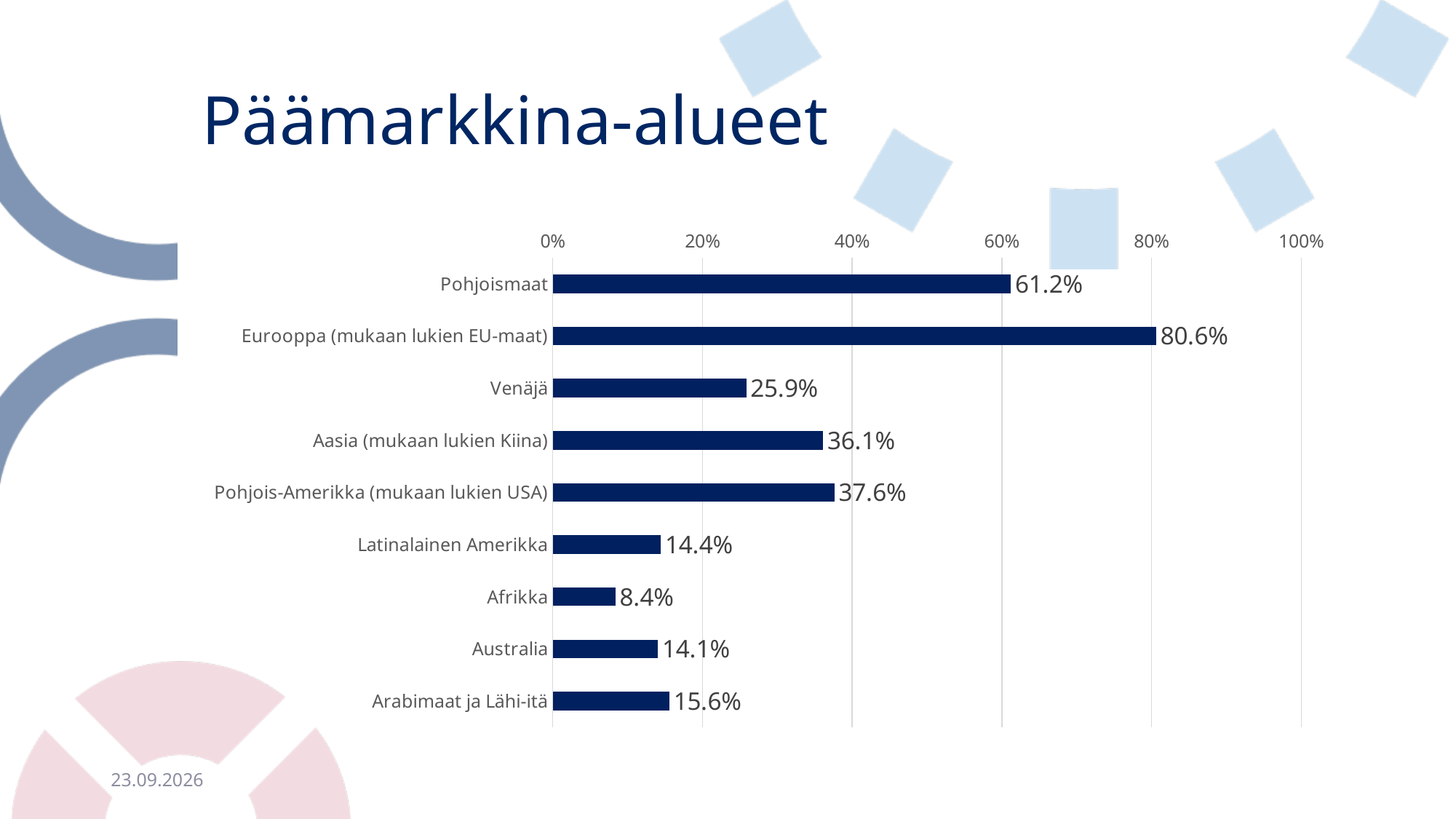
What kind of chart is shown on the slide? bar chart What is the value for Pohjoismaat? 61.2% What is the value for Arabimaat ja Lähi-itä? 15.6% How many categories are shown in the chart? 9 What is the difference between the values for Eurooppa (mukaan lukien EU-maat) and Pohjoismaat? 19.4% Which category has the highest value? Eurooppa (mukaan lukien EU-maat) Which category has the lowest value? Afrikka What is the value for Venäjä? 25.9% What is the value for Afrikka? 8.4% Is the value for Pohjois-Amerikka (mukaan lukien USA) greater or less than 40%? less What is the title of the slide? Päämarkkina-alueet Which is larger, the value for Venäjä or the value for Aasia (mukaan lukien Kiina)? Aasia (mukaan lukien Kiina)